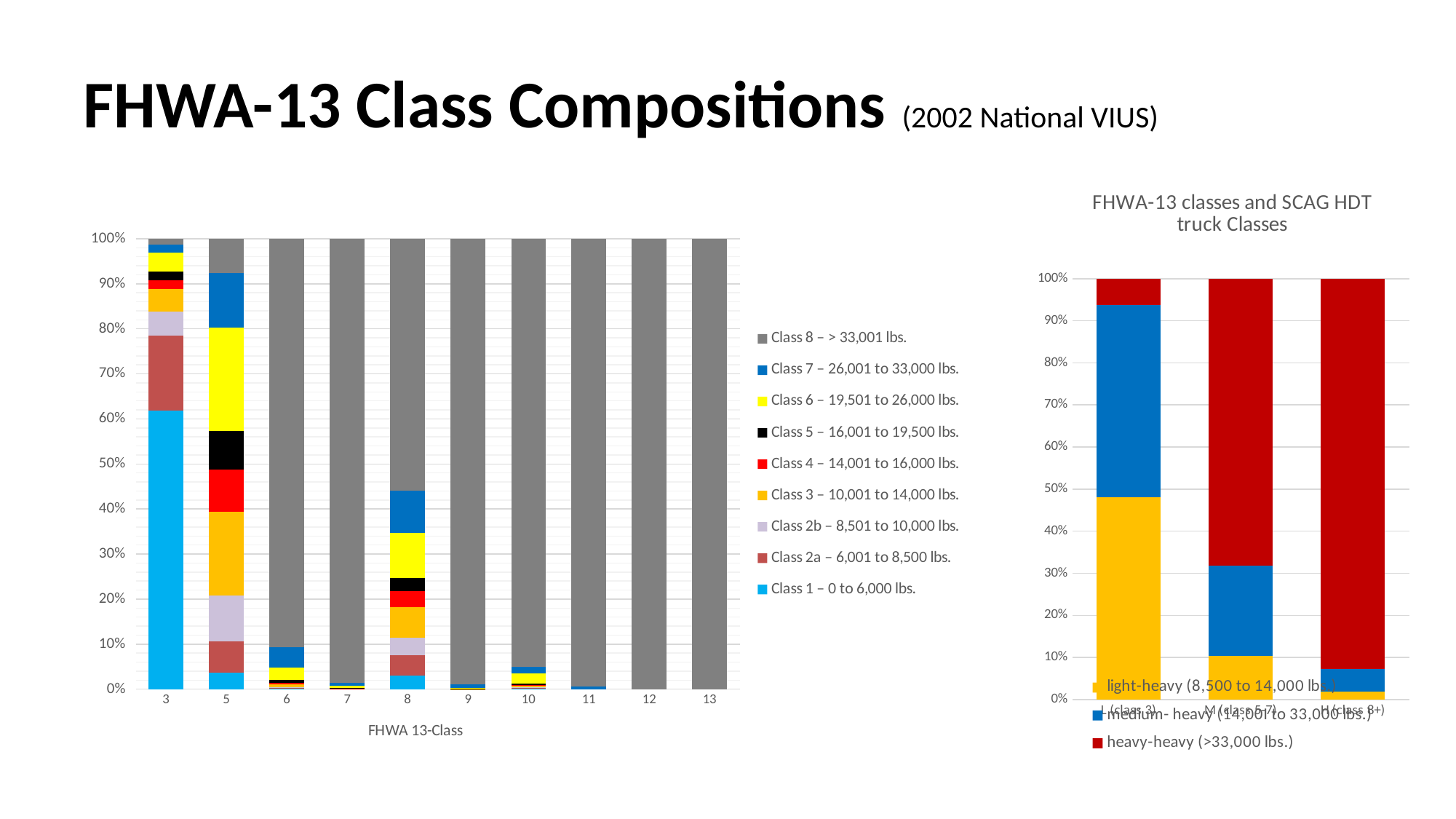
How many series does the legend of the right chart 'FHWA-13 classes and SCAG HDT truck Classes' list? 3 How many FHWA 13-Class categories are shown on the x axis of the left chart? 10 What is the title of the right chart? FHWA-13 classes and SCAG HDT truck Classes In the left chart, is the Class 8 share for FHWA class 5 greater or less than 10%? less In the left chart, which legend entry corresponds to the grey colour? Class 8 – > 33,001 lbs. What kind of chart is the left chart on the slide? stacked bar chart In the left chart, is the Class 8 share for FHWA class 6 greater or less than 80%? greater In the left chart, does the Class 8 share generally rise or fall moving from FHWA class 3 to class 13? rise How many series does the legend of the left chart list? 9 In the left chart, is the Class 1 share for FHWA class 3 greater or less than 50%? greater In the left chart, which has the larger Class 1 share: FHWA class 3 or FHWA class 5? FHWA class 3